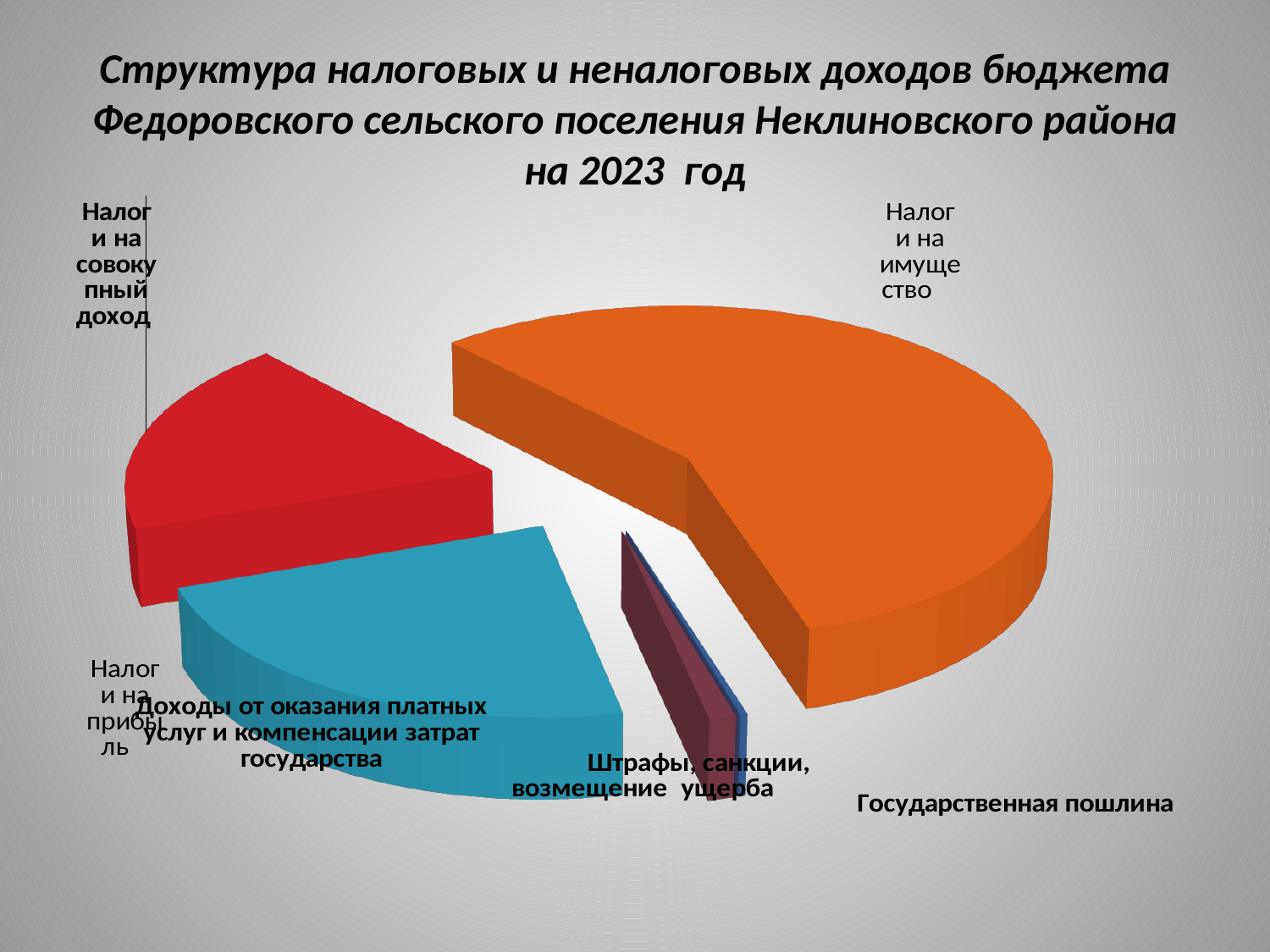
What kind of chart is shown on the slide? pie chart What colour is the largest slice of the pie? orange Which category has the largest slice of the pie? Налоги на имущество Which is larger: the slice for Налоги на имущество or the slice for Доходы от оказания платных услуг и компенсации затрат государства? Налоги на имущество What year does the chart title refer to? 2023 Which is larger: the slice for Налоги на имущество or the slice for Штрафы, санкции, возмещение ущерба? Налоги на имущество Does the slice for Налоги на имущество take up more or less than half of the pie? more How many categories are labelled on the pie chart? 6